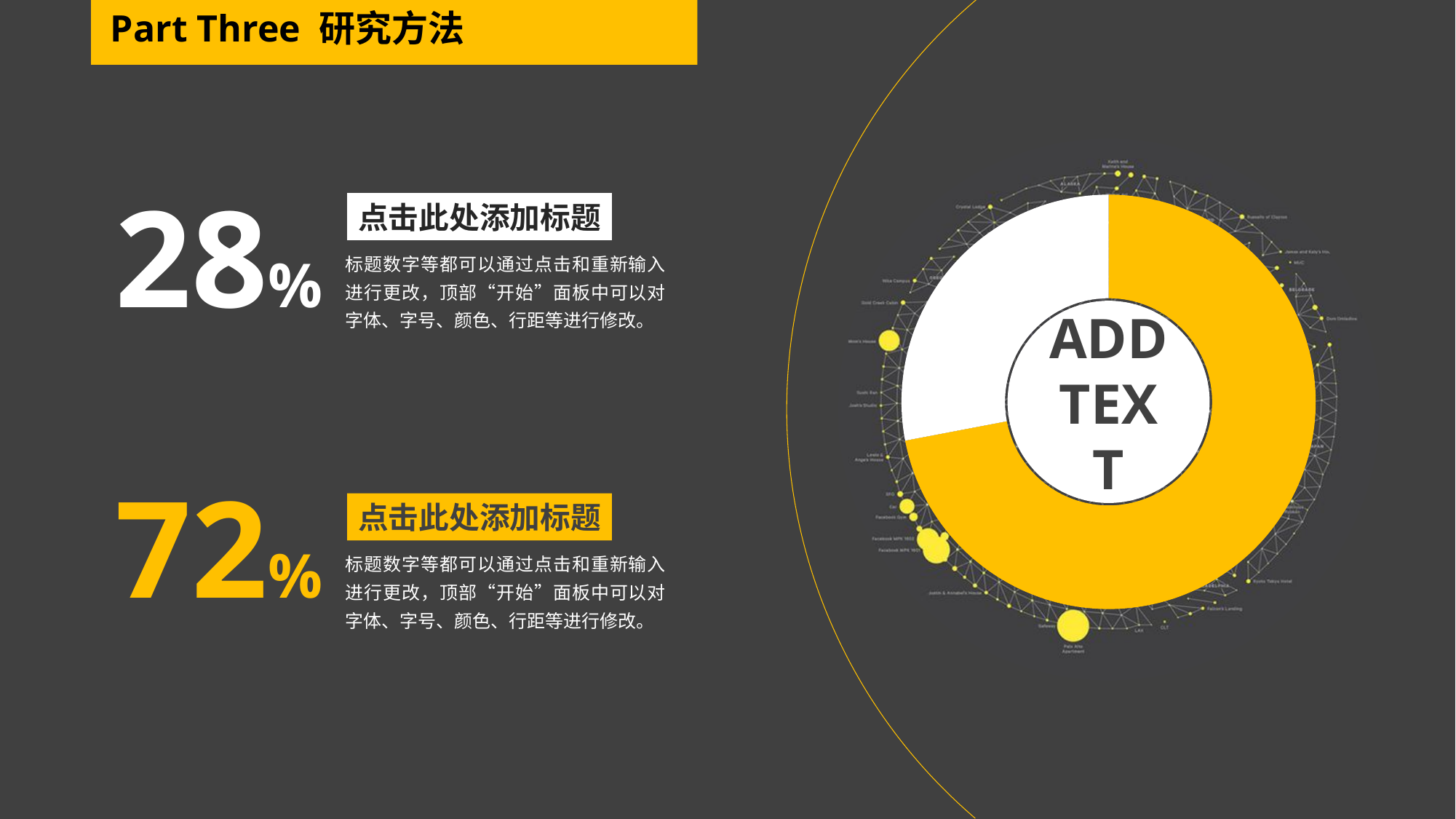
What is the difference between the two percentages shown on the slide, 72% and 28%? 44% What text is printed in the centre of the donut chart? ADD TEXT Which slice of the donut chart is the smallest? the white slice What colour is the larger slice of the donut chart? yellow What percentage is shown in yellow on the left of the slide, matching the yellow slice of the donut chart? 72% Is the yellow slice of the donut chart greater or less than half of the whole? greater How many slices does the donut chart have? 2 What kind of chart is shown on the right side of the slide? pie chart (donut) Which slice of the donut chart is larger, the yellow one or the white one? yellow What percentage is shown in white on the left of the slide, matching the white slice of the donut chart? 28%